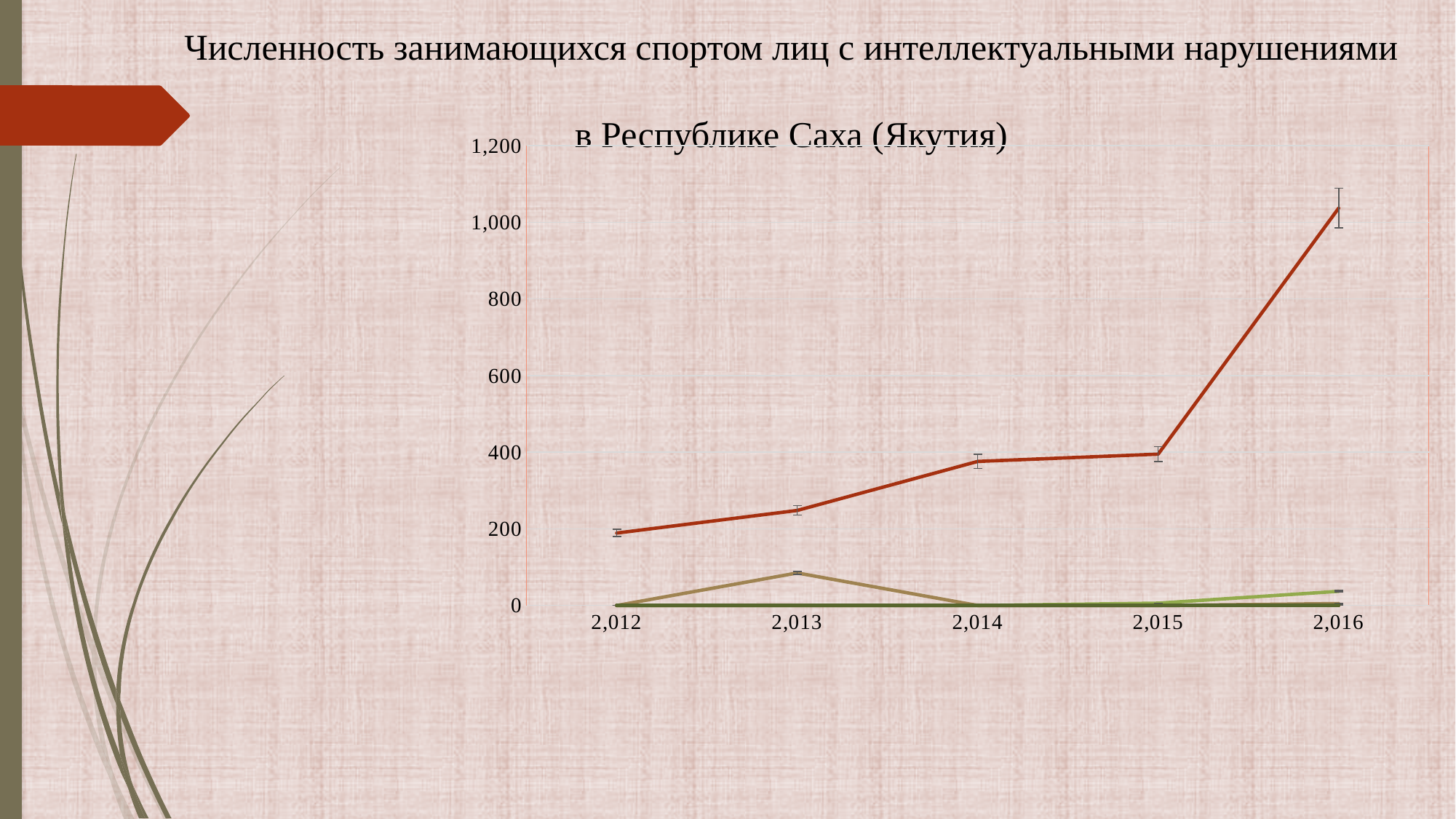
In which year does the red line reach its highest value? 2,016 Is the value of the red line in 2,014 greater or less than 200? greater Is the value of the red line in 2,016 greater or less than 1,000? greater Does the red line rise or fall from 2,012 to 2,016? rise What kind of chart is shown on the slide? line chart How many years are shown along the x axis of the chart? 5 In which year does the red line have its lowest value? 2,012 Which is larger for the red line: the value in 2,013 or the value in 2,015? 2,015 What is the first year shown on the x axis of the chart? 2,012 What is the highest value shown on the y axis of the chart? 1,200 Is the value of the red line in 2,015 greater or less than 600? less